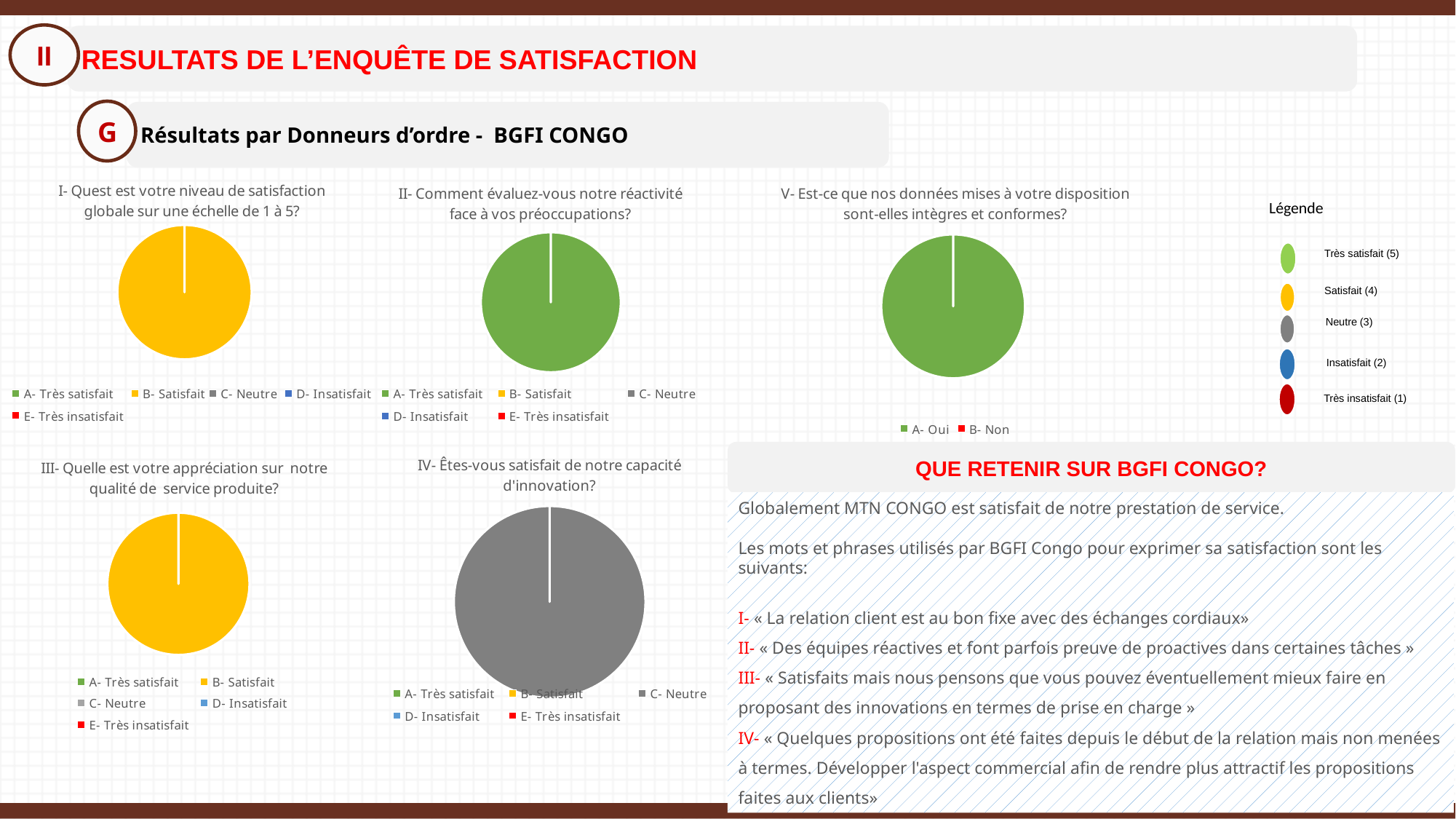
In the chart for question IV (capacité d'innovation), which category accounts for the largest share of the pie? C- Neutre In the legend of the chart for question I (satisfaction globale), which category is shown in red? E- Très insatisfait In the chart for question III (qualité de service produite), which category accounts for the largest share of the pie? B- Satisfait In the chart for question V (données intègres et conformes), which category accounts for the largest share of the pie? A- Oui In the chart for question IV (capacité d'innovation), is the share for C- Neutre larger or smaller than the share for A- Très satisfait? Larger How many entries does the legend of the chart for question V (données intègres et conformes) list? 2 What colour is the pie in the chart for question III (qualité de service produite)? Yellow How many pie charts are shown on the slide? 5 How many entries does the legend of the chart for question II (réactivité face à vos préoccupations) list? 5 What kind of chart is used for question I ("Quest est votre niveau de satisfaction globale sur une échelle de 1 à 5?")? Pie chart